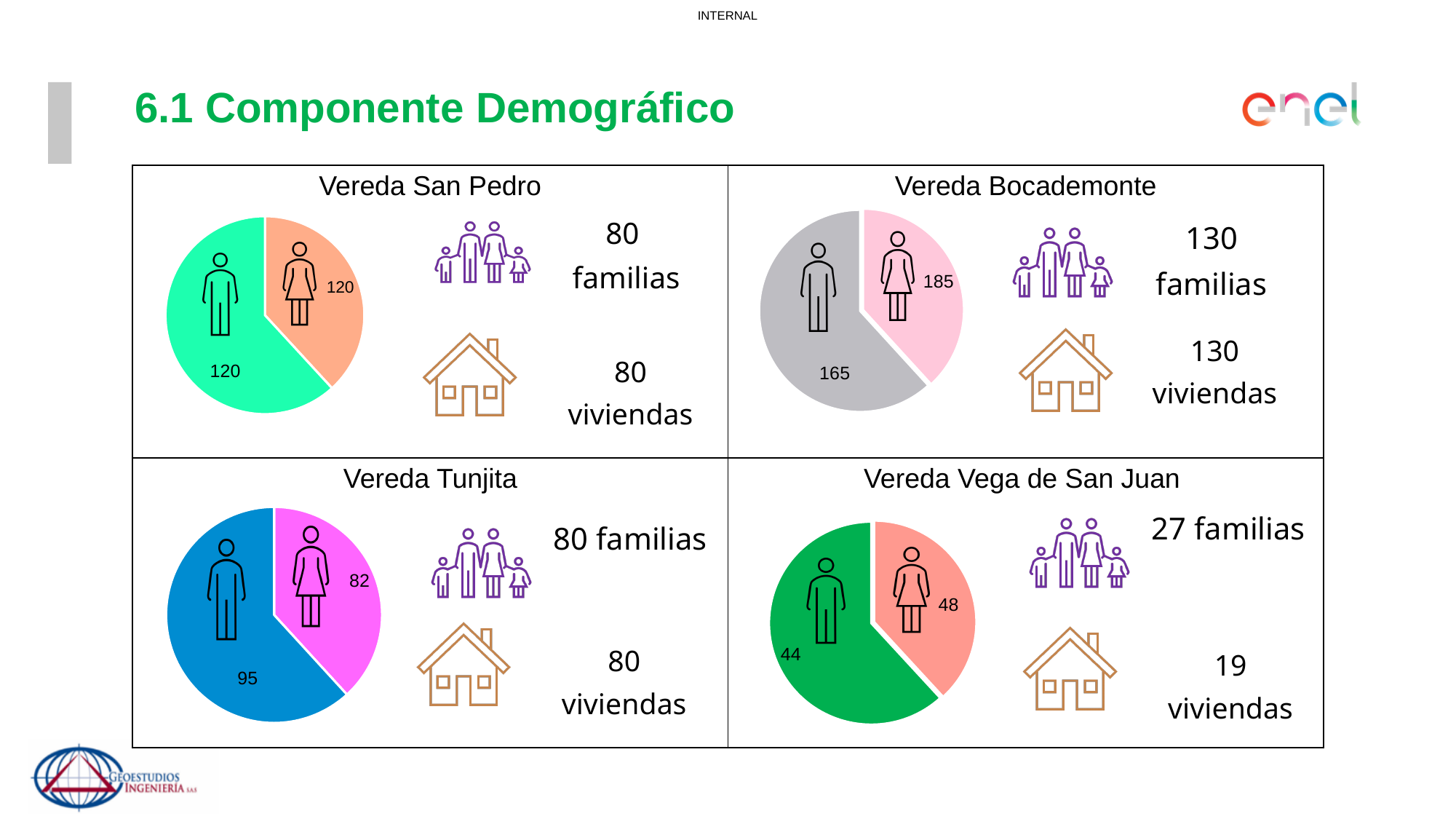
In the Vereda Tunjita pie chart, which slice has the larger value, the one with the male figure or the one with the female figure? the one with the male figure In the Vereda Tunjita pie chart, what is the difference between the slice values 95 and 82? 13 In the Vereda Vega de San Juan pie chart, what value is shown on the slice with the male figure? 44 What kind of chart is used in the Vereda San Pedro panel? pie chart How many slices does the Vereda San Pedro pie chart have? 2 In the Vereda Bocademonte pie chart, what value is shown on the slice with the male figure? 165 In the Vereda Bocademonte pie chart, what is the total of the two slice values? 350 In the Vereda Bocademonte pie chart, what is the difference between the two slice values? 20 In the Vereda Bocademonte pie chart, what value is shown on the slice with the female figure? 185 In the Vereda Tunjita pie chart, what is the total of the two slice values? 177 How many pie charts are shown on the slide? 4